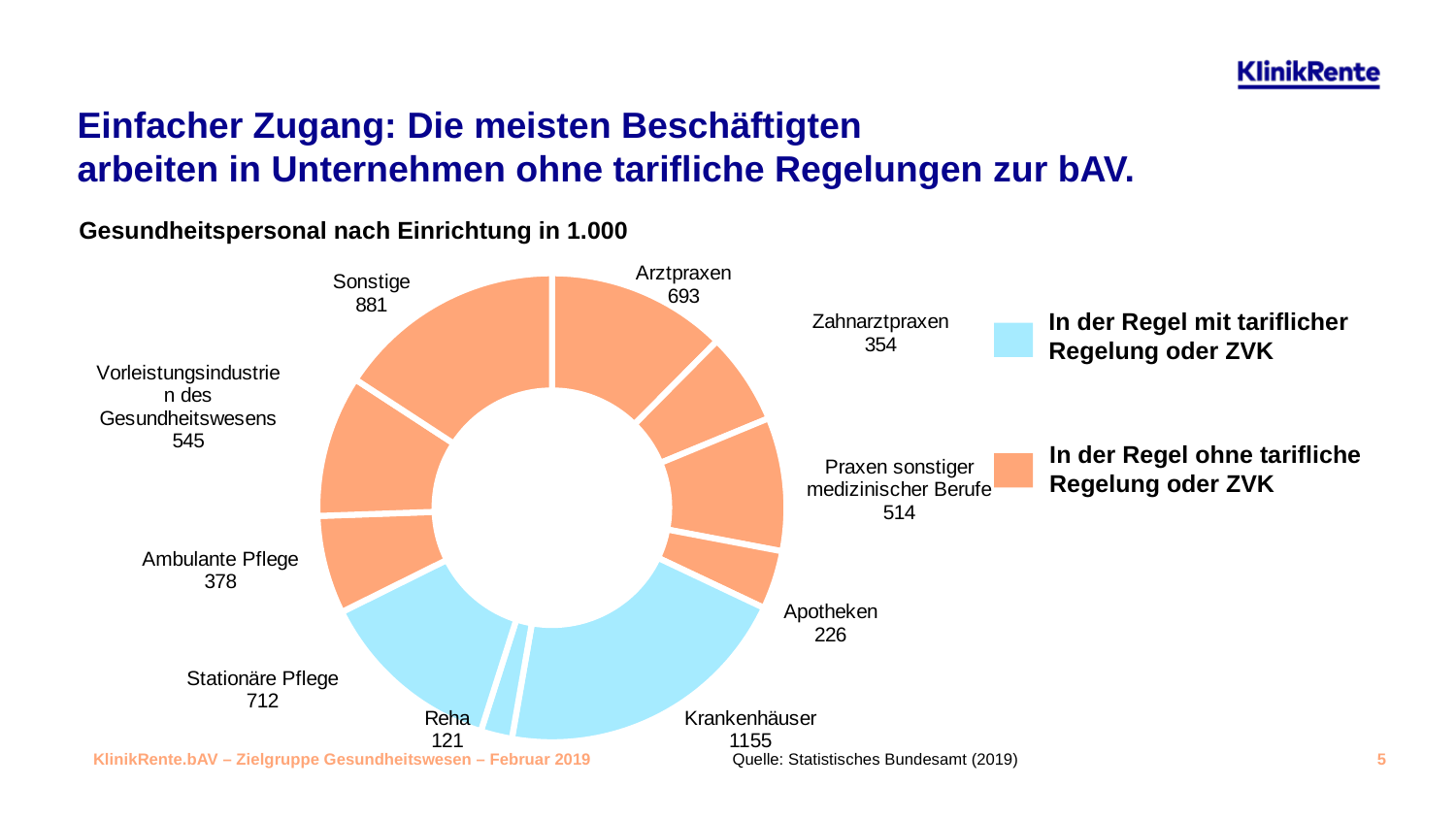
What is the value for Praxen sonstiger medizinischer Berufe? 514 How many categories are shown in the chart? 10 How many entries does the legend list? 2 What is the difference between the values for Sonstige and Arztpraxen? 188 What is the value for Ambulante Pflege? 378 What is the value for Krankenhäuser? 1155 Which category has the highest value? Krankenhäuser What kind of chart is shown on the slide? Doughnut (pie) chart What is the title of the chart? Gesundheitspersonal nach Einrichtung in 1.000 Which is larger, Stationäre Pflege or Vorleistungsindustrien des Gesundheitswesens? Stationäre Pflege Which category has the lowest value? Reha What is the value for Zahnarztpraxen? 354